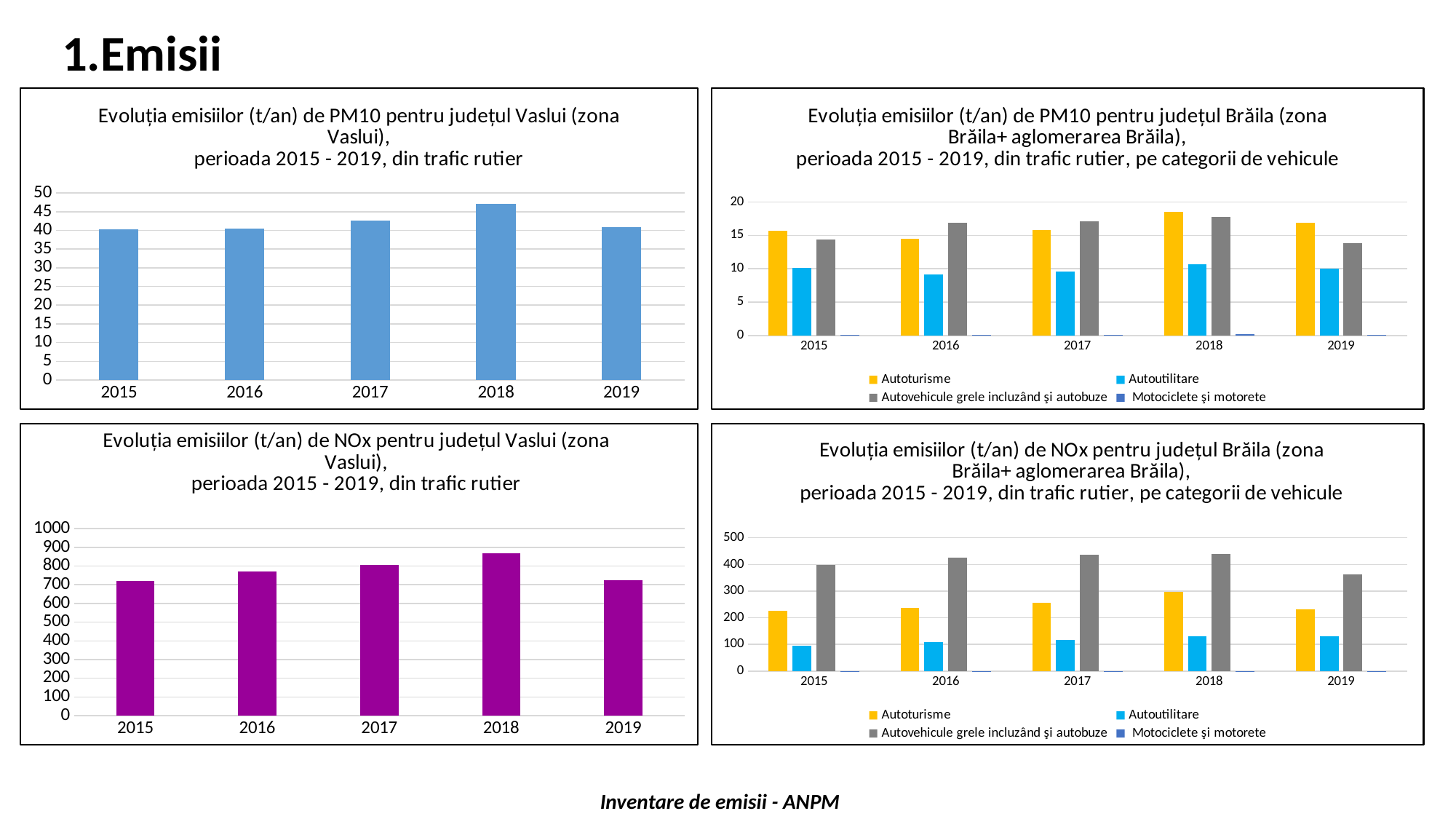
In the top-right chart (PM10 Brăila), is the value for Autoturisme in 2018 greater or less than 15? greater How many series does the legend list in the top-right chart (PM10 Brăila)? 4 How many years are shown on the x axis of the top-left chart (PM10 Vaslui)? 5 In the bottom-right chart (NOx Brăila), which series has the highest value in 2017, Autoturisme or Autovehicule grele incluzând și autobuze? Autovehicule grele incluzând și autobuze In the top-left chart (PM10 Vaslui), which year has the highest emissions? 2018 In the top-left chart (PM10 Vaslui), is the value for 2015 greater or less than 45? less In the top-left chart (PM10 Vaslui), is the value for 2018 greater or less than 45? greater What kind of chart is the bottom-left chart (NOx Vaslui)? bar chart In the bottom-left chart (NOx Vaslui), which year has the highest emissions? 2018